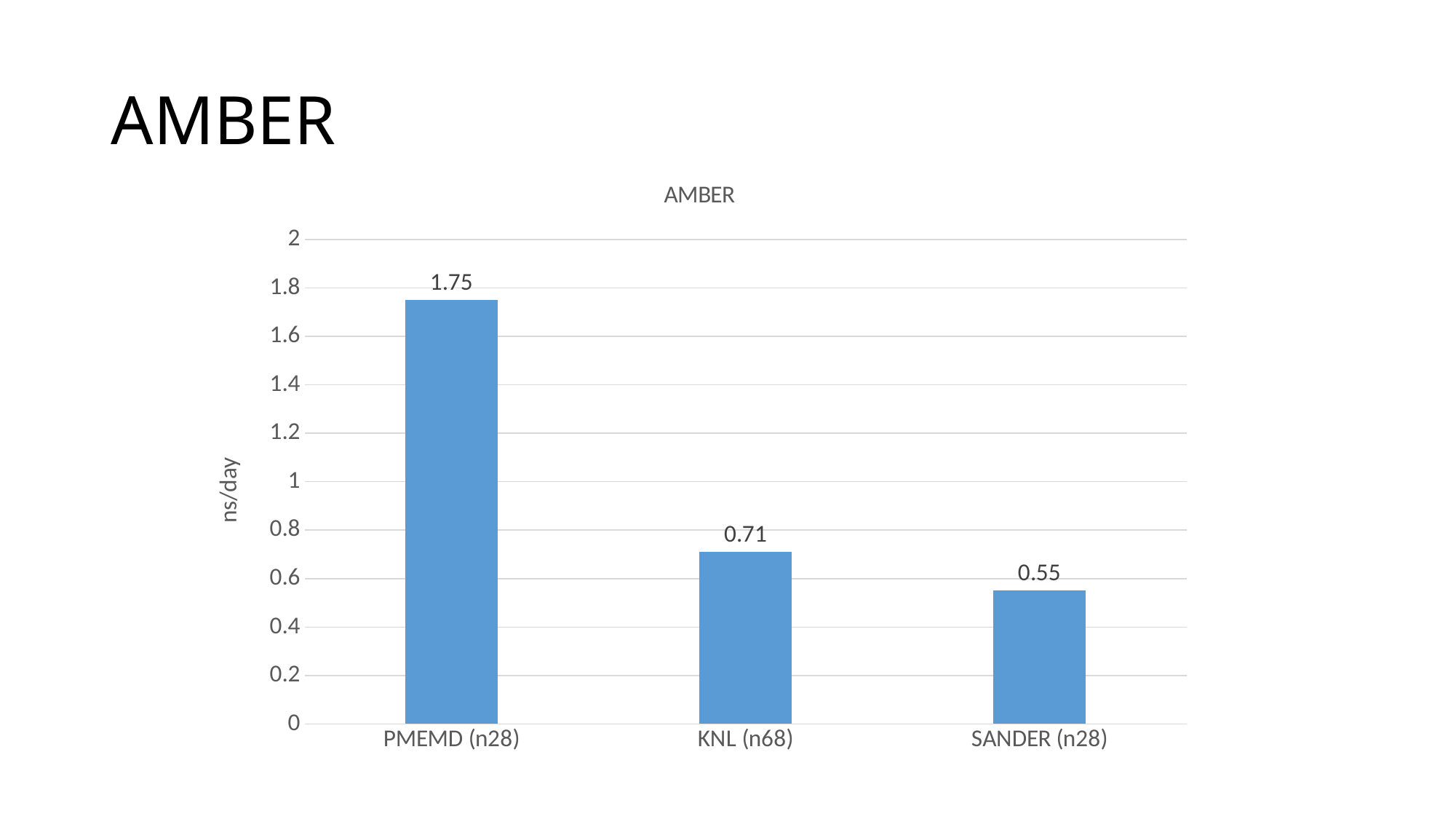
Which category has the highest value? PMEMD (n28) What is the difference between the values for KNL (n68) and SANDER (n28)? 0.16 What is the value for KNL (n68)? 0.71 How many categories are shown on the x axis? 3 What is the value for PMEMD (n28)? 1.75 What kind of chart is shown on the slide? bar chart Which is larger, the value for KNL (n68) or the value for SANDER (n28)? KNL (n68) Which category has the lowest value? SANDER (n28) What is the label of the y axis? ns/day What is the difference between the values for PMEMD (n28) and KNL (n68)? 1.04 Is the value for PMEMD (n28) greater or less than 1? greater What is the value for SANDER (n28)? 0.55